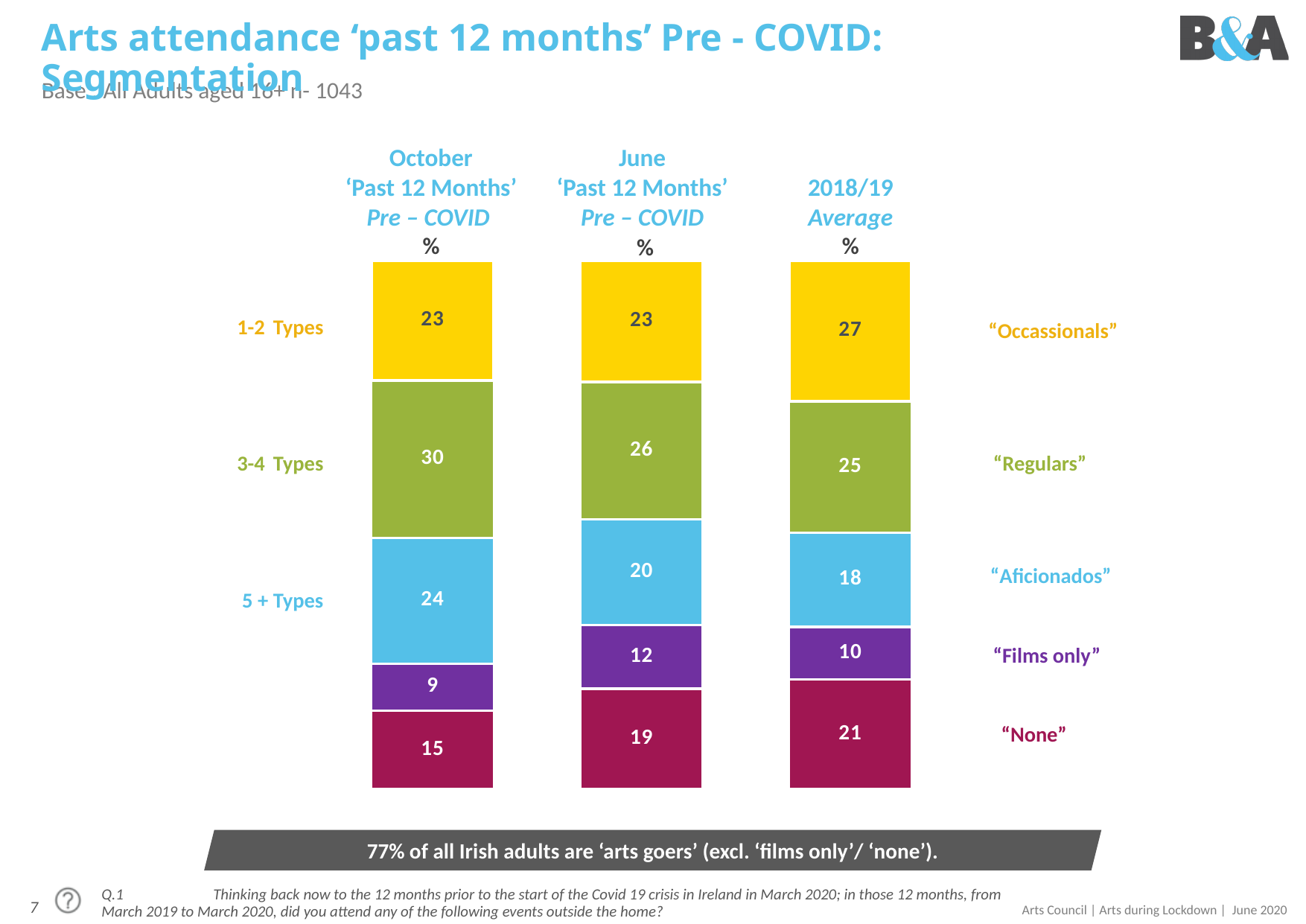
Which segment is the largest in the June 'Past 12 Months' Pre-COVID bar? "Regulars" What is the total of the June 'Past 12 Months' Pre-COVID bar? 100 How many segments does each stacked bar contain? 5 Which is larger: "Occassionals" in the 2018/19 Average bar or "Occassionals" in the October bar? 2018/19 Average What is the value for "None" in the 2018/19 Average bar? 21 What is the difference between the "None" values in the June bar and the October bar? 4 What is the value for "Aficionados" in the October 'Past 12 Months' Pre-COVID bar? 24 What kind of chart is shown on the slide? Stacked bar chart What is the value for "Regulars" in the October 'Past 12 Months' Pre-COVID bar? 30 Which segment is the smallest in the October 'Past 12 Months' Pre-COVID bar? "Films only" How many bars are shown in the chart? 3 What is the value for "Films only" in the June 'Past 12 Months' Pre-COVID bar? 12